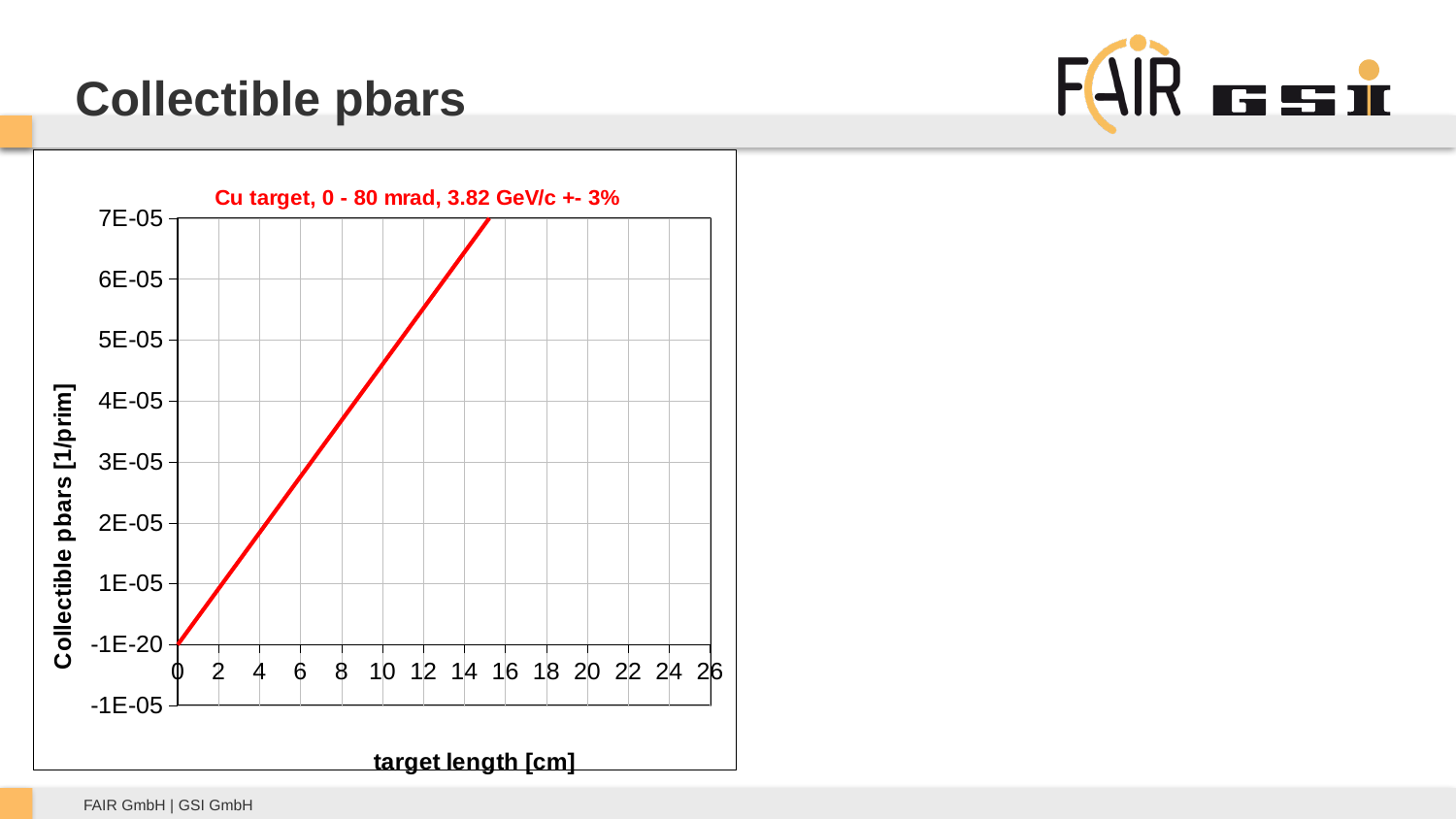
Is the value for a target length of 8 cm greater or less than 3E-05? greater Is the value for a target length of 12 cm greater or less than 5E-05? greater Which is larger, the value at a target length of 6 cm or at 12 cm? 12 cm What is the title of the chart? Cu target, 0 - 80 mrad, 3.82 GeV/c +- 3% Is the value for a target length of 10 cm greater or less than 4E-05? greater What is the highest tick value shown on the y axis? 7E-05 What kind of chart is shown on the slide? line chart What is the label of the x axis? target length [cm] How many lines (series) are plotted on the chart? 1 Does the collectible pbars value rise or fall as target length increases? rise